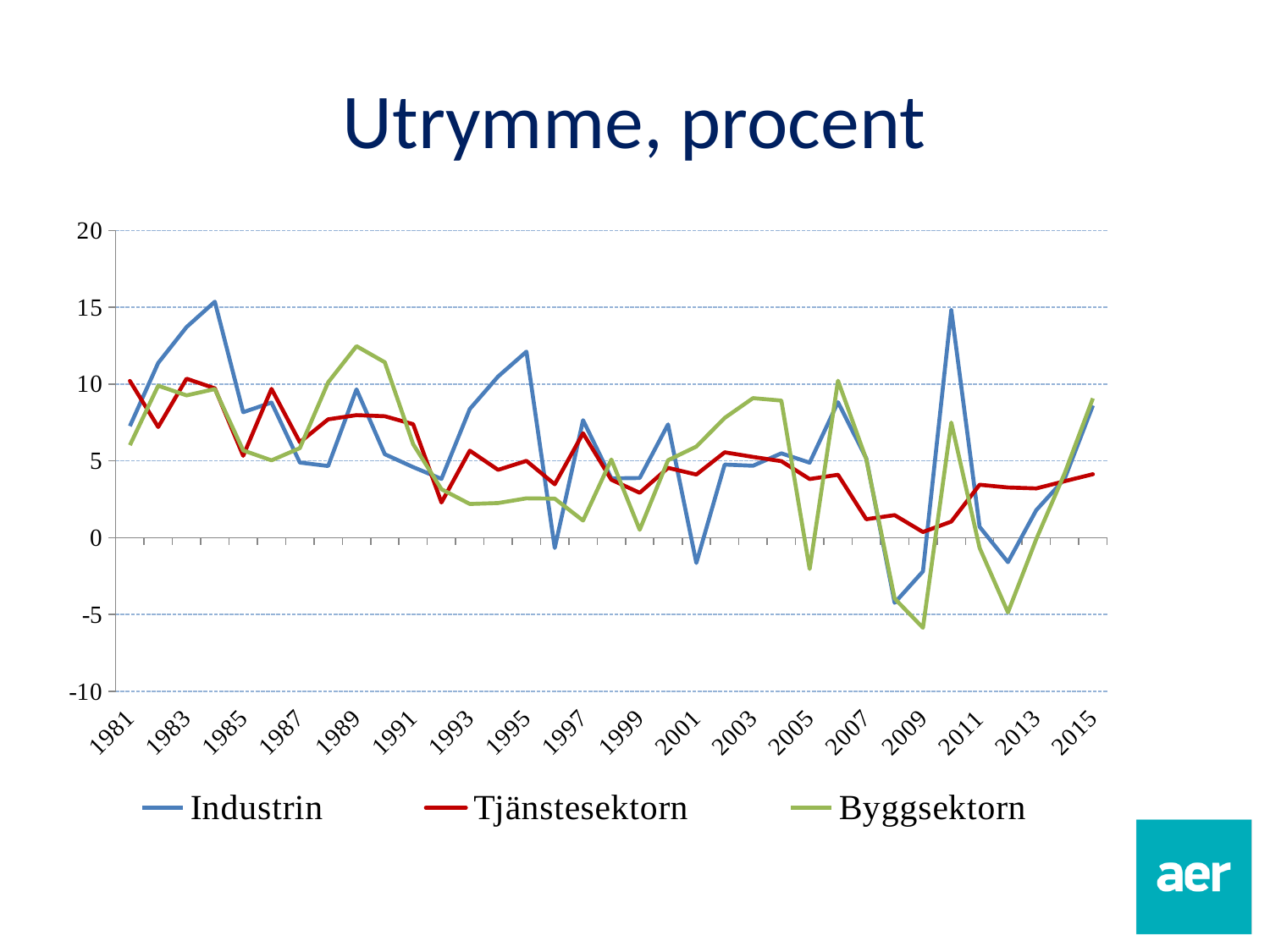
In 1984, which series has the higher value, Industrin or Tjänstesektorn? Industrin Which colour is used for the Byggsektorn series? Green What kind of chart is shown on the slide? Line chart What is the title of the chart? Utrymme, procent Is the value for Industrin in 1984 greater or less than 10? greater In 2009, which series has the higher value, Tjänstesektorn or Byggsektorn? Tjänstesektorn Is the value for Industrin in 2001 greater or less than 0? less Is the value for Tjänstesektorn in 2009 greater or less than 5? less Overall, does the Tjänstesektorn series rise or fall from 1981 to 2015? Fall How many series does the legend list? 3